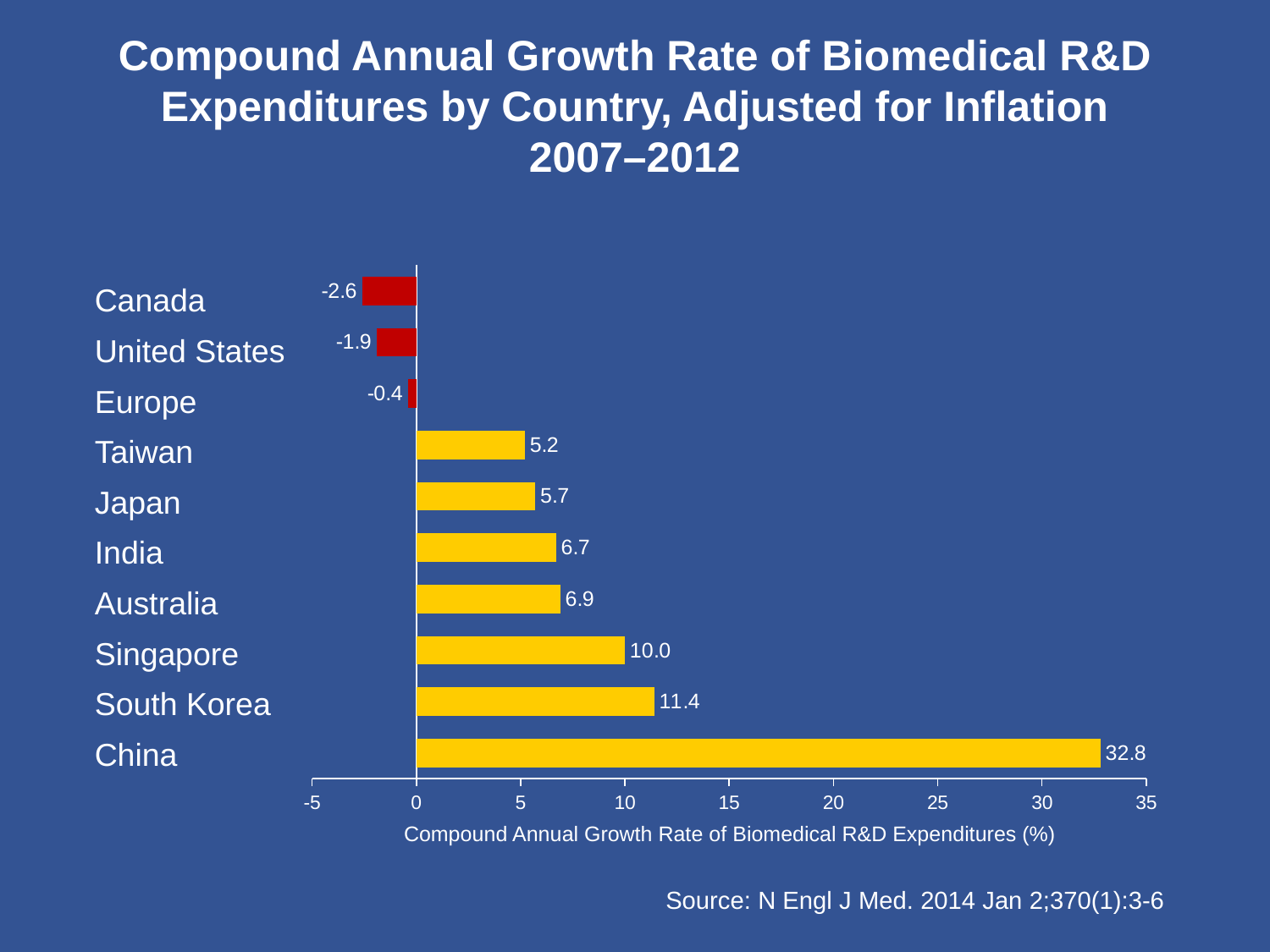
How many countries or regions have a negative growth rate? 3 What is the value shown for Singapore? 10.0 Which country has the highest compound annual growth rate? China Which country has the lowest compound annual growth rate? Canada How many countries or regions are shown in the chart? 10 What is the difference between the values for South Korea and Singapore? 1.4 Is the value for South Korea greater or less than 10? greater What is the compound annual growth rate shown for China? 32.8 What is the label on the horizontal axis of the chart? Compound Annual Growth Rate of Biomedical R&D Expenditures (%) What kind of chart is shown on the slide? Bar chart What value is shown for Canada? -2.6 Which has a larger value, India or Japan? India